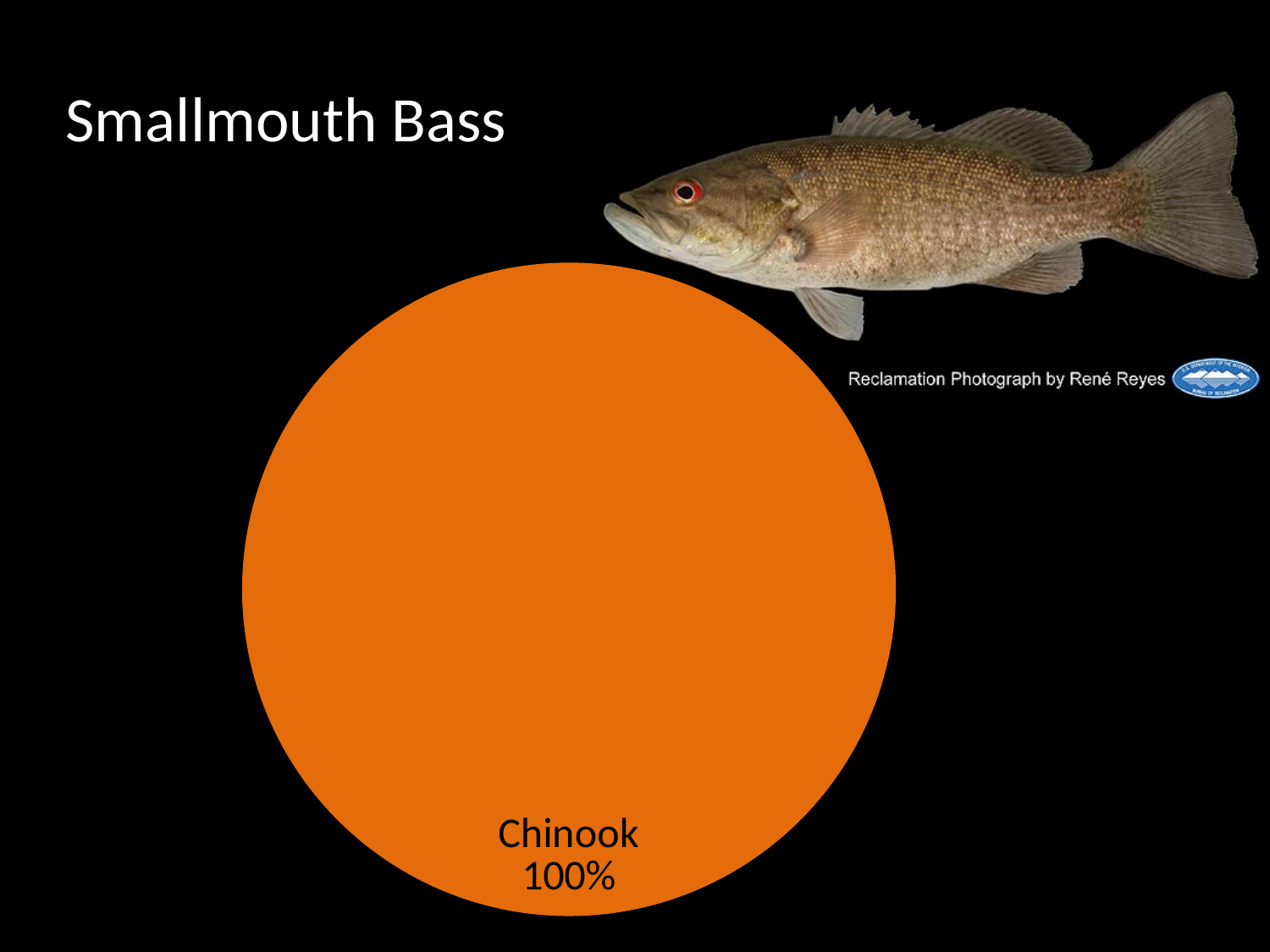
What is the title of the slide containing the pie chart? Smallmouth Bass What is the label of the only slice in the pie chart? Chinook What kind of chart is shown on the slide? pie chart Is the share for Chinook in the pie chart greater or less than 50%? greater What share of the pie chart does the Chinook slice represent? 100% What colour is the Chinook slice in the pie chart? orange How many slices does the pie chart have? 1